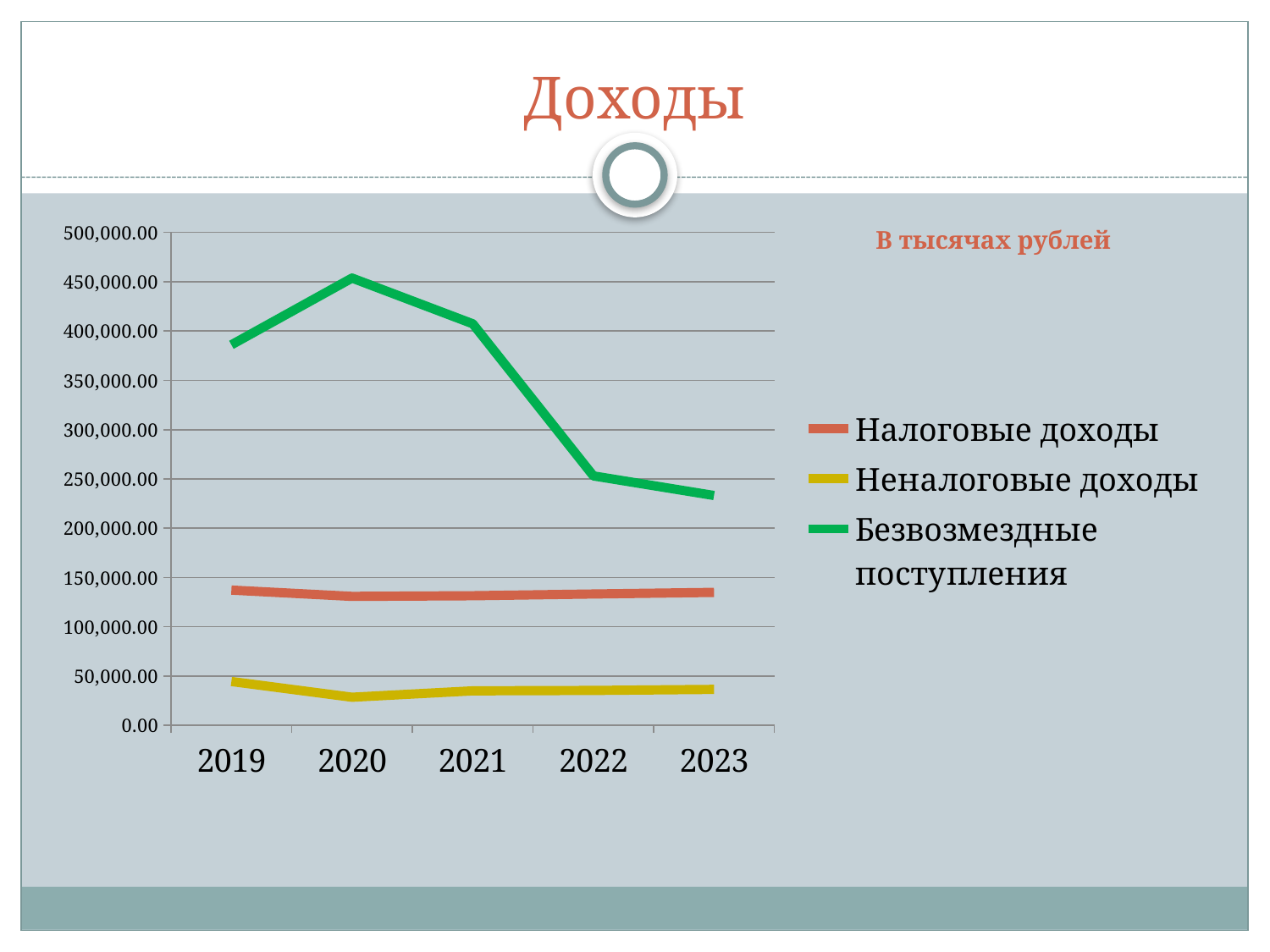
Is the value for Безвозмездные поступления in 2020 greater or less than 400,000.00? greater Is the value for Налоговые доходы in 2019 greater or less than 150,000.00? less What kind of chart is shown on the slide? line chart In which year is the value for Безвозмездные поступления lowest? 2023 Which series has the larger value in 2019, Налоговые доходы or Безвозмездные поступления? Безвозмездные поступления In which year is the value for Безвозмездные поступления highest? 2020 In which year is the value for Неналоговые доходы lowest? 2020 What unit note is printed above the legend? В тысячах рублей How many years are shown on the x axis? 5 How many series does the legend list? 3 Is the value for Безвозмездные поступления in 2023 greater or less than 250,000.00? less Does the value for Безвозмездные поступления rise or fall from 2020 to 2023? fall